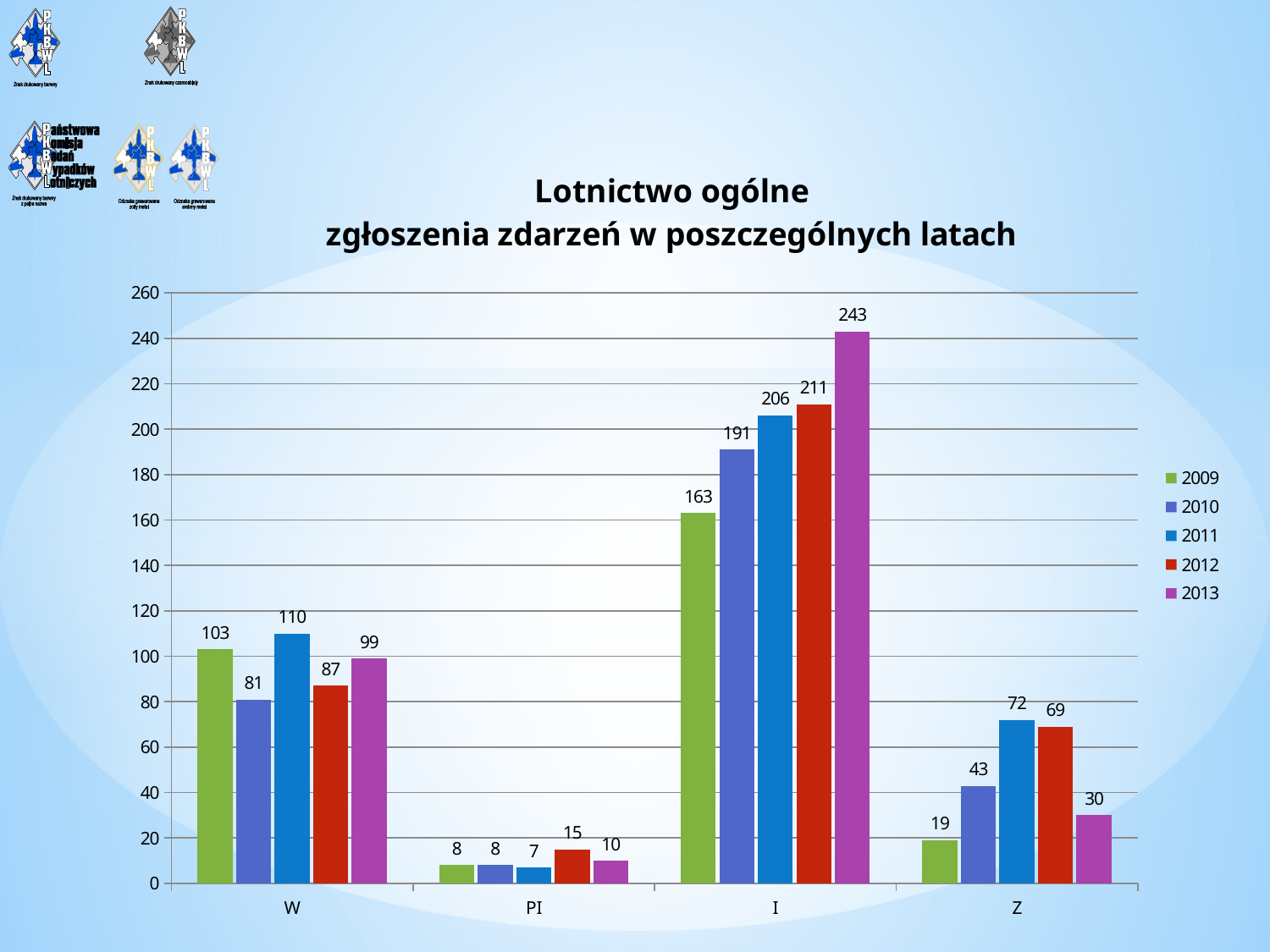
What is the difference between the 2013 and 2009 values for category I? 80 How many series does the legend list? 5 What is the value for category I in the 2013 series? 243 What kind of chart is shown on the slide? bar chart Which is larger for category Z: the 2011 value or the 2012 value? 2011 Which category has the lowest value in the 2010 series? PI What is the value for category Z in the 2009 series? 19 Which category has the highest value in the 2012 series? I Is the value for category W in the 2010 series greater or less than 100? less What is the value for category W in the 2011 series? 110 How many categories are shown on the x axis? 4 Which year does the purple series represent in the legend? 2013